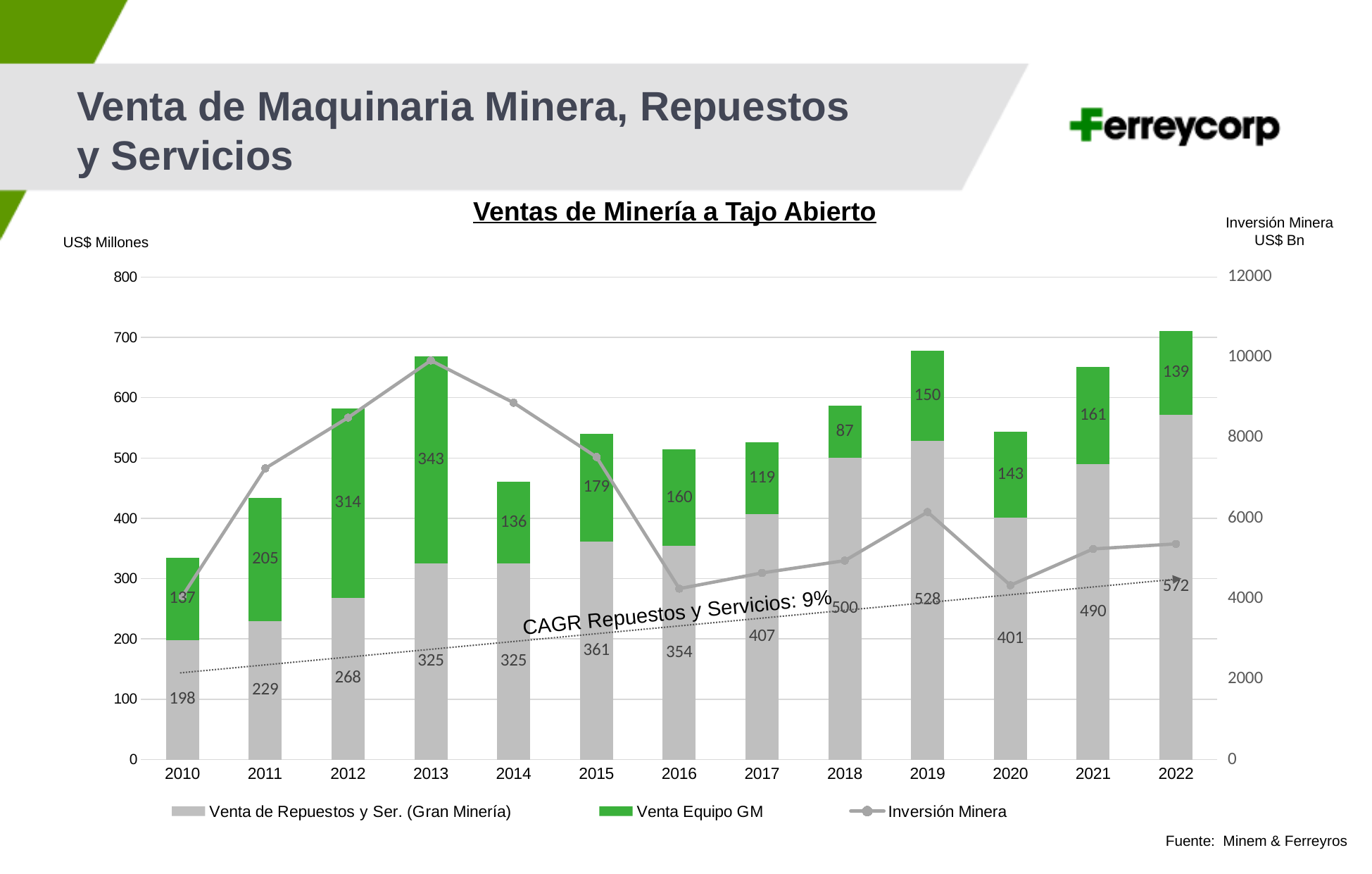
What is the value of Venta de Repuestos y Ser. (Gran Minería) for 2018? 500 How many series does the legend list? 3 In which year is Venta de Repuestos y Ser. (Gran Minería) highest? 2022 What CAGR for Repuestos y Servicios is annotated on the chart? 9% How many years are shown on the x axis? 13 What is the difference between Venta de Repuestos y Ser. (Gran Minería) in 2022 and in 2010? 374 What is the total of the stacked bar for 2013? 668 What is the value of Venta Equipo GM for 2012? 314 Is the Inversión Minera value for 2013 greater or less than 8000? greater In which year is Venta Equipo GM highest? 2013 Which year has the larger Venta Equipo GM value, 2011 or 2015? 2011 In which year is Venta Equipo GM lowest? 2018